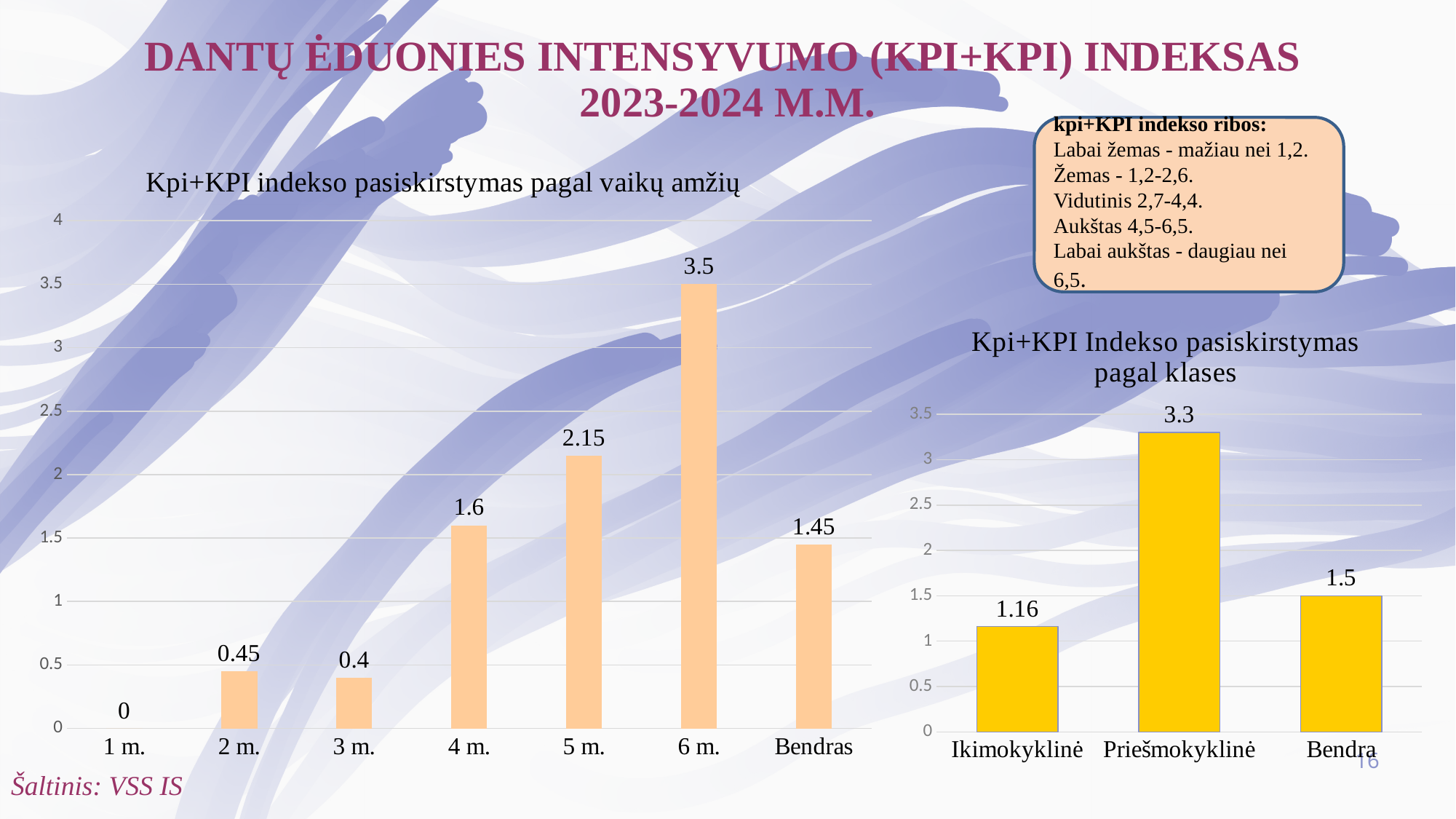
What kind of chart is 'Kpi+KPI Indekso pasiskirstymas pagal klases'? Bar chart How many categories are shown in the chart 'Kpi+KPI Indekso pasiskirstymas pagal klases'? 3 In the chart 'Kpi+KPI indekso pasiskirstymas pagal vaikų amžių', which category has the highest value? 6 m. In the chart 'Kpi+KPI Indekso pasiskirstymas pagal klases', what is the value for Ikimokyklinė? 1.16 In the chart 'Kpi+KPI indekso pasiskirstymas pagal vaikų amžių', what is the value for 5 m.? 2.15 In the chart 'Kpi+KPI indekso pasiskirstymas pagal vaikų amžių', which category has the lowest value? 1 m. In the chart 'Kpi+KPI Indekso pasiskirstymas pagal klases', which category has the highest value? Priešmokyklinė In the chart 'Kpi+KPI indekso pasiskirstymas pagal vaikų amžių', what is the value for Bendras? 1.45 How many categories are shown in the chart 'Kpi+KPI indekso pasiskirstymas pagal vaikų amžių'? 7 In the chart 'Kpi+KPI Indekso pasiskirstymas pagal klases', what is the difference between the values for Priešmokyklinė and Bendra? 1.8 In the chart 'Kpi+KPI indekso pasiskirstymas pagal vaikų amžių', which is larger, the value for 2 m. or 3 m.? 2 m. In the chart 'Kpi+KPI indekso pasiskirstymas pagal vaikų amžių', what is the difference between the values for 6 m. and 4 m.? 1.9